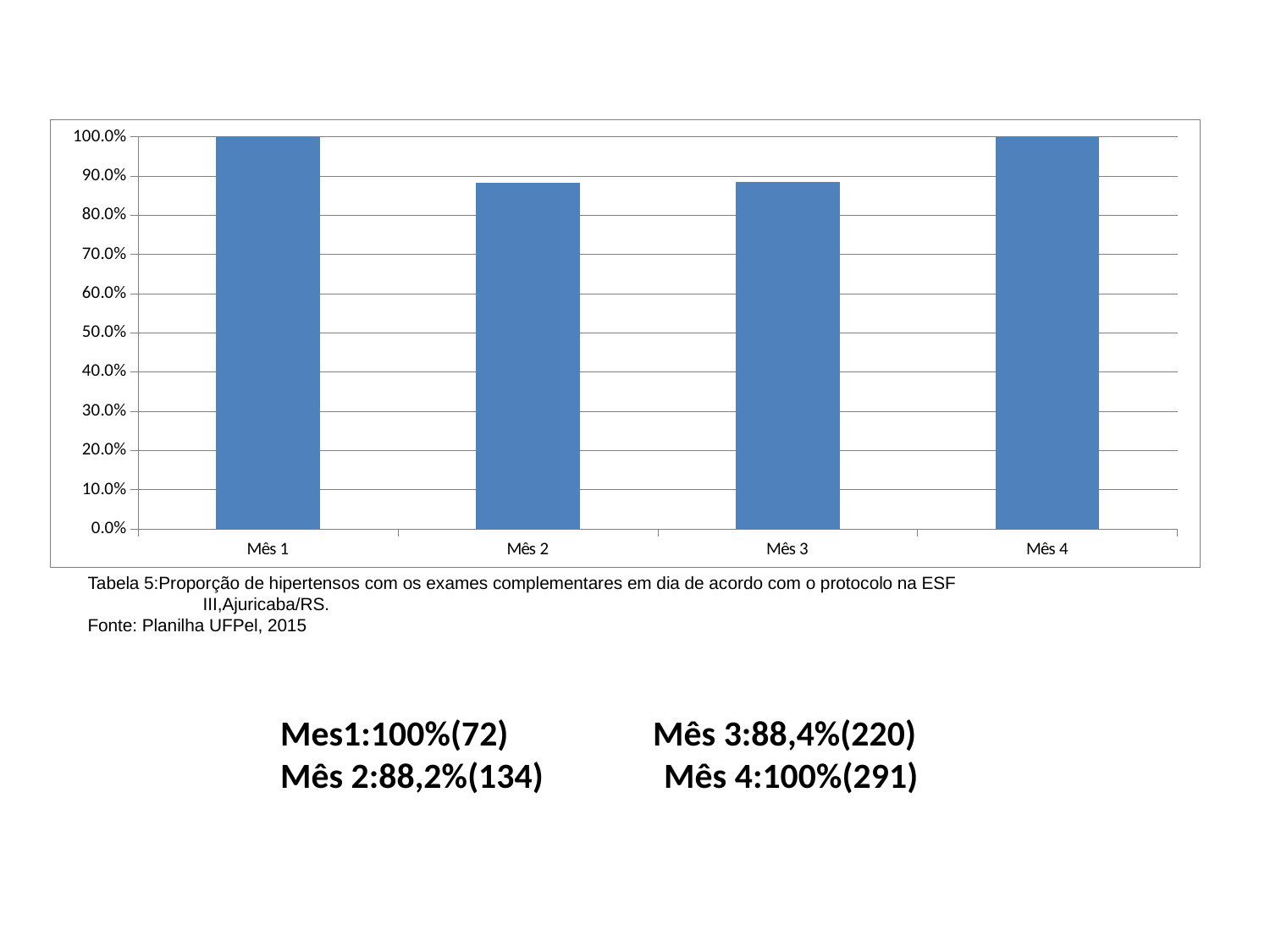
Which months have the highest value in the chart? Mês 1 and Mês 4 How many months are shown on the x axis of the chart? 4 Which is larger, the value for Mês 4 or the value for Mês 2? Mês 4 What is the value for Mês 1? 100% What is the value for Mês 3? 88,4% Is the value for Mês 3 greater or less than 80.0%? greater What is the value for Mês 2? 88,2% What kind of chart is shown on the slide? bar chart What is the value for Mês 4? 100% What source is cited below the chart? Planilha UFPel, 2015 What is the difference between the value for Mês 1 and the value for Mês 2? 11,8% Is the value for Mês 2 greater or less than 90.0%? less